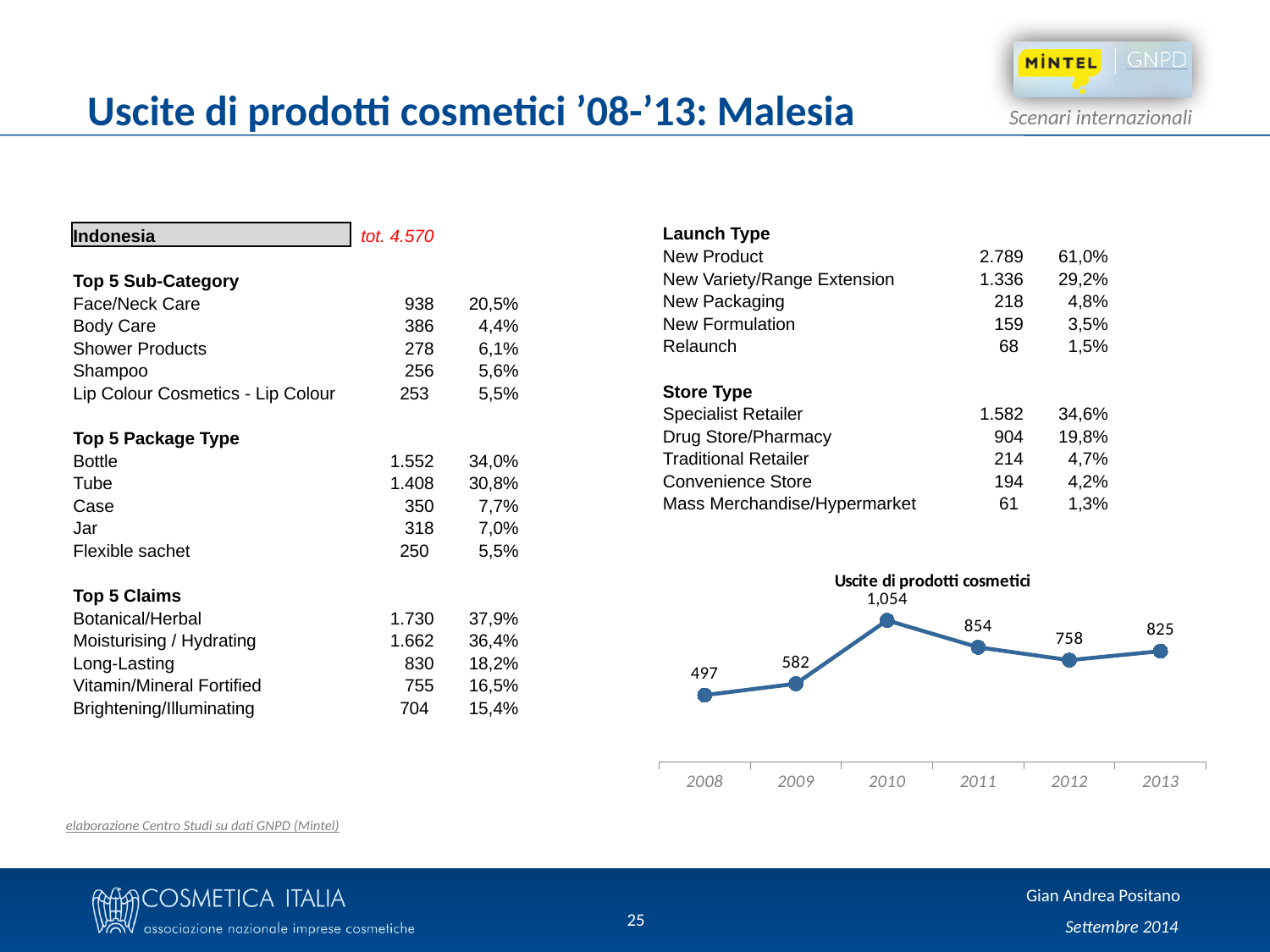
Which year has the highest value in the chart? 2010 Do the values rise or fall from 2008 to 2010? rise What is the title of the chart? Uscite di prodotti cosmetici Which year has the lowest value in the chart? 2008 What is the value for 2008 in the chart? 497 What is the difference between the values for 2009 and 2008? 85 How many data points are plotted in the chart? 6 What kind of chart is shown on the slide? line chart What is the value for 2010 in the chart? 1,054 What is the value for 2013 in the chart? 825 What is the difference between the values for 2010 and 2011? 200 Which is larger, the value for 2012 or the value for 2013? 2013